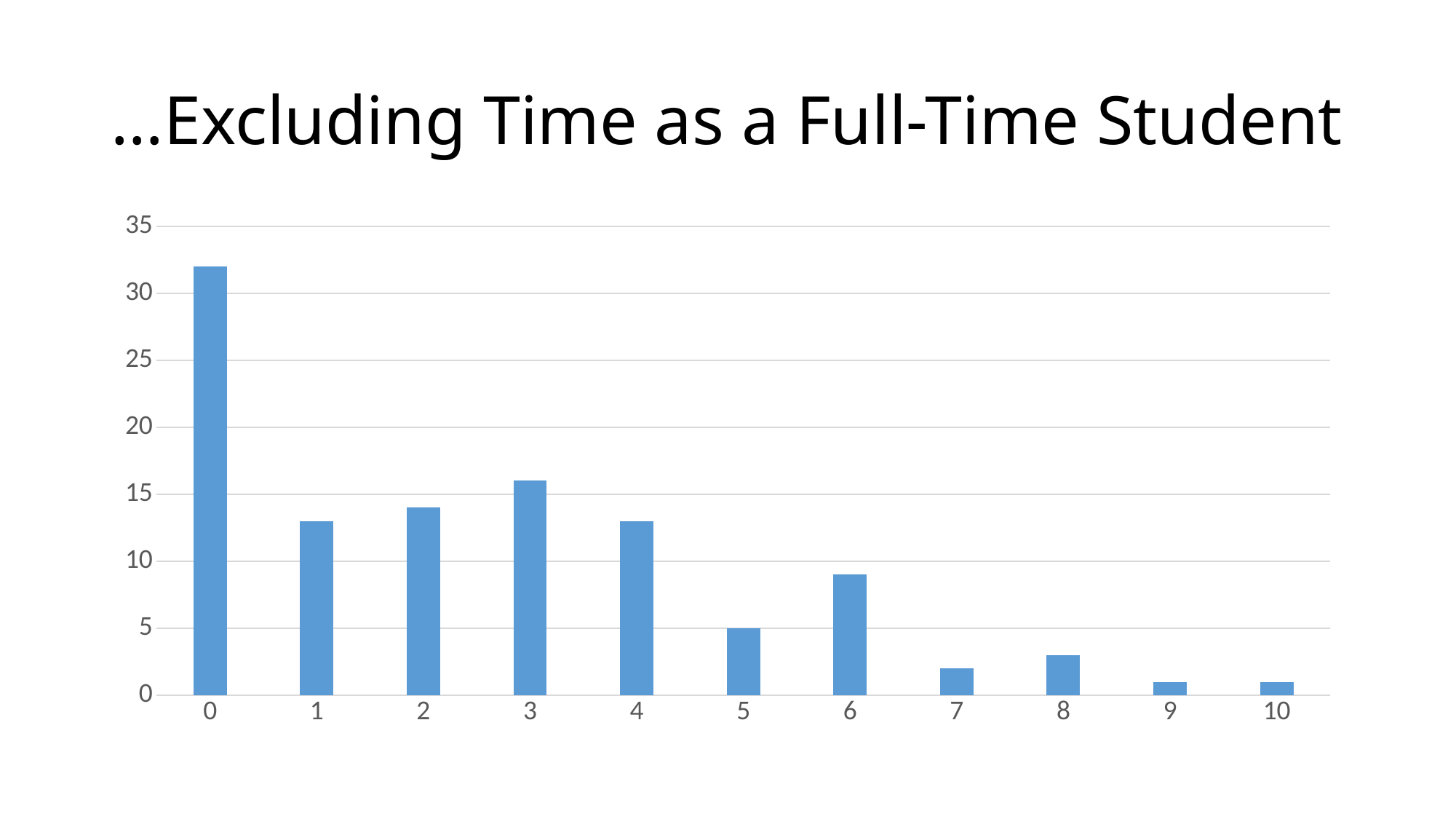
Do the values generally rise or fall from category 0 to category 10? fall Which is larger, the value for category 3 or the value for category 4? 3 What is the value for category 5? 5 Is the value for category 0 greater or less than 30? greater How many categories are shown on the x axis? 11 Is the value for category 1 greater or less than 15? less Which category has the highest bar? 0 Is the value for category 3 greater or less than 15? greater What is the title of the slide? …Excluding Time as a Full-Time Student What kind of chart is shown on the slide? bar chart Which is larger, the value for category 6 or the value for category 5? 6